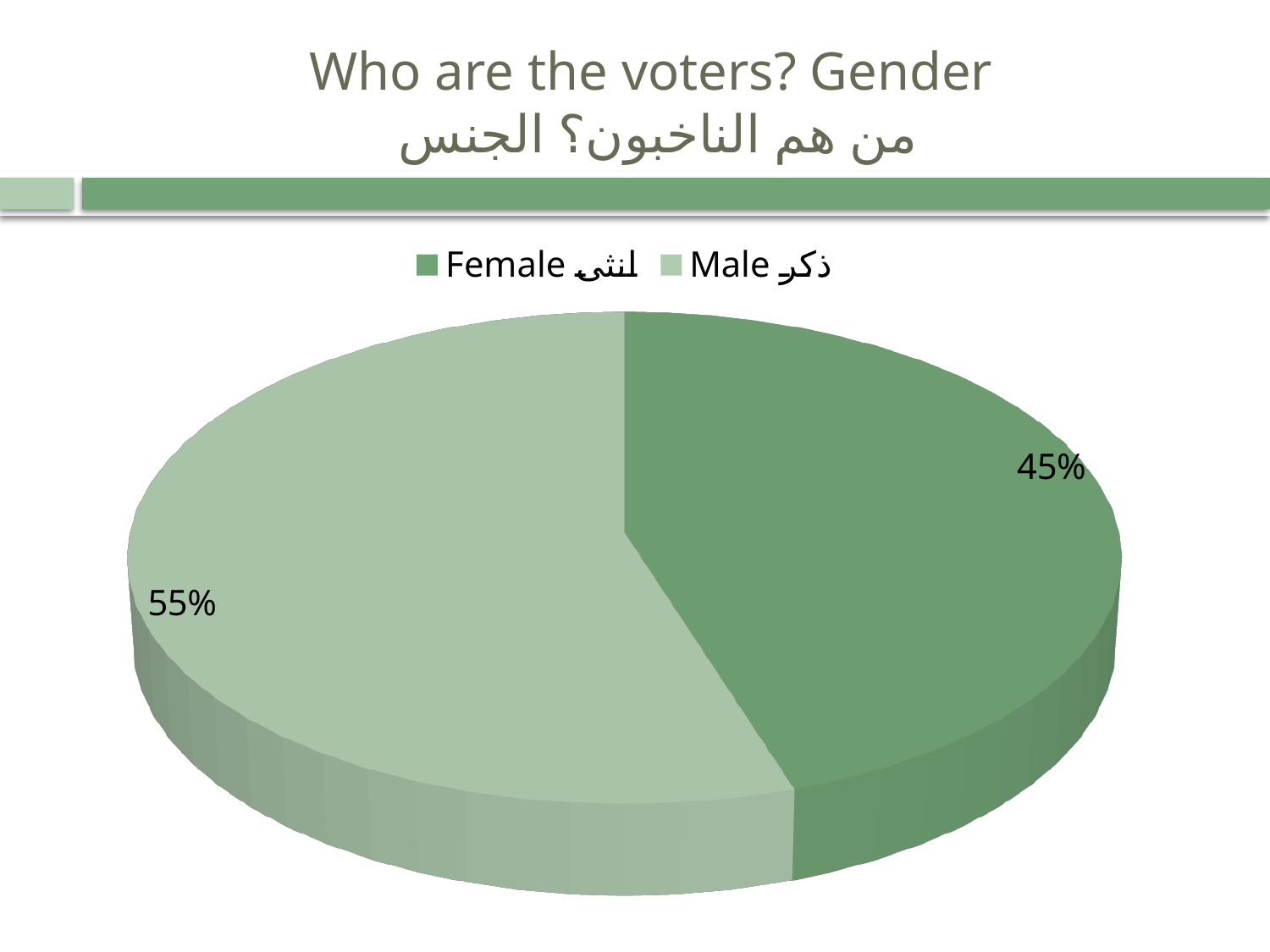
Is the share for Male larger or smaller than the share for Female? Larger What is the English part of the slide title? Who are the voters? Gender Is the share for Female greater or less than 50%? less Which gender has the larger share of voters? Male What percentage of voters are female? 45% What is the difference in percentage points between the male and female shares? 10% Which gender has the smaller share of voters? Female What kind of chart is shown on the slide? Pie chart What percentage of voters are male? 55% Which legend entry is shown in the darker green colour? Female How many entries does the legend list? 2 How many slices does the pie chart have? 2